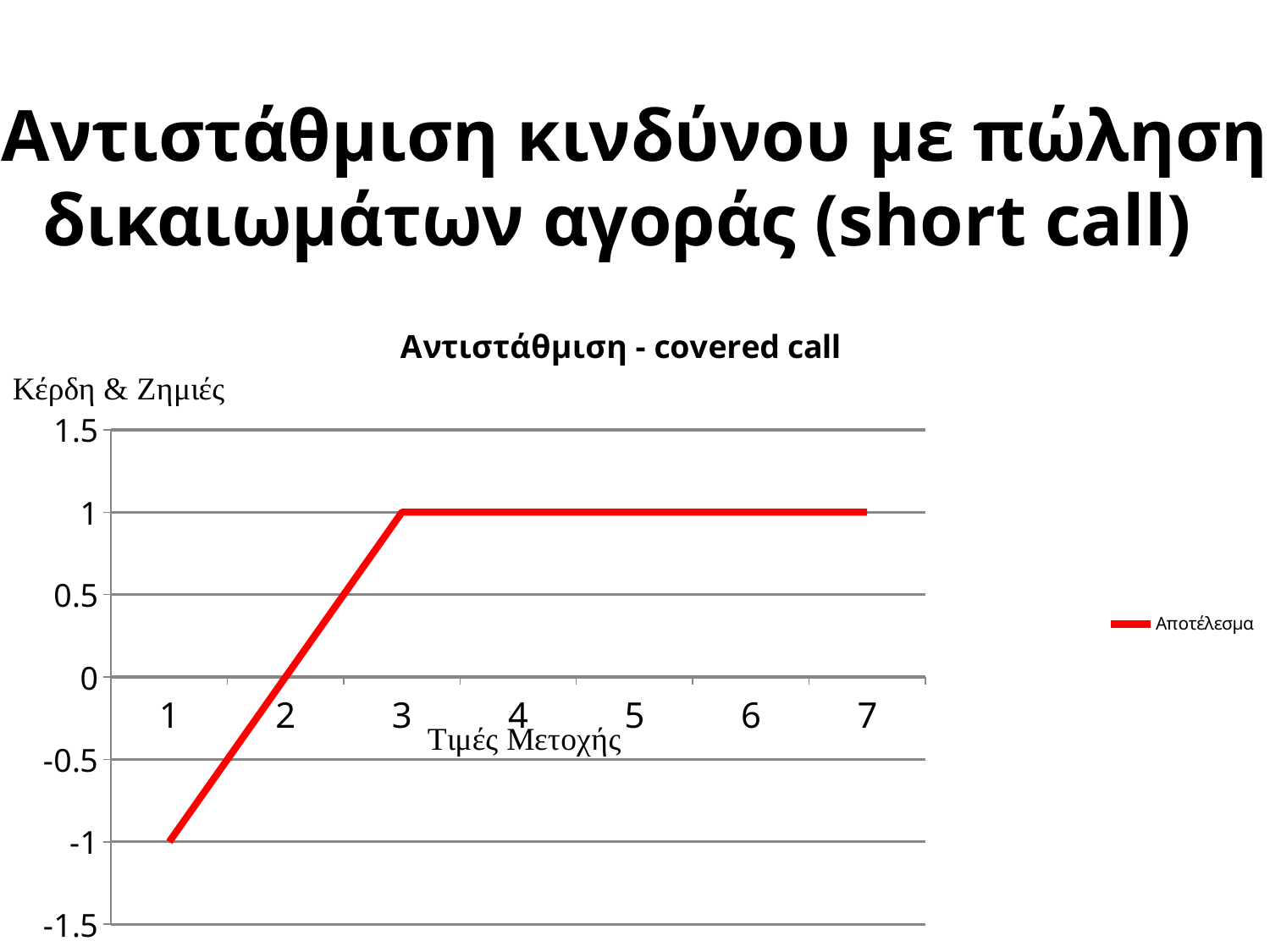
How many series does the legend list? 1 What is the name of the series in the legend? Αποτέλεσμα At which share price is the value of Αποτέλεσμα lowest? 1 What is the value of Αποτέλεσμα at share price 7? 1 What is the value of Αποτέλεσμα at share price 1? -1 What kind of chart is shown on the slide? line chart How many points are plotted along the x axis? 7 Is the value of Αποτέλεσμα at share price 1 greater or less than -0.5? less Does the value of Αποτέλεσμα rise or fall from share price 1 to share price 3? rise What is the value of Αποτέλεσμα at share price 2? 0 What is the value of Αποτέλεσμα at share price 3? 1 What is the title of the chart? Αντιστάθμιση - covered call